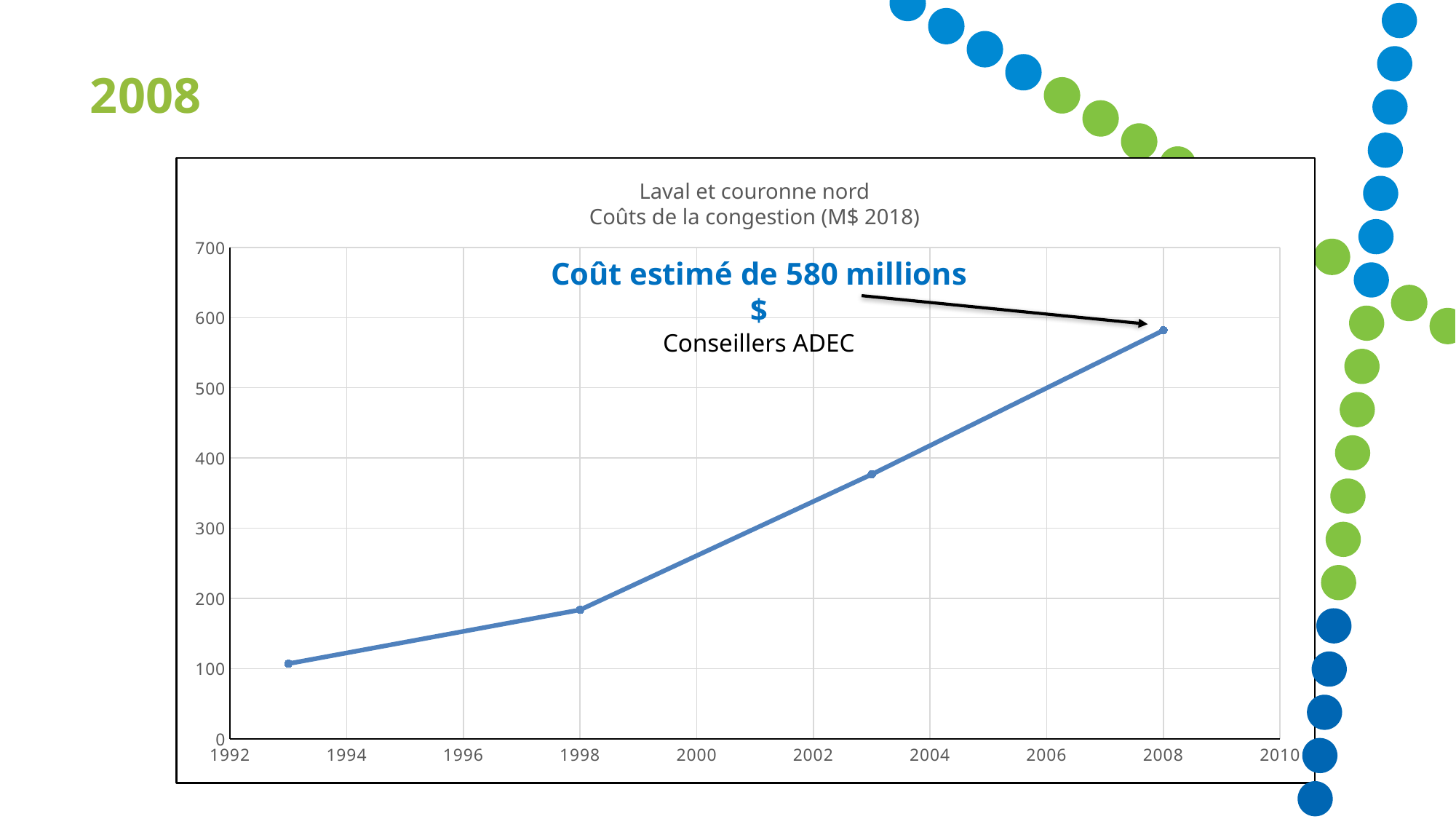
What is the title of the chart? Laval et couronne nord Coûts de la congestion (M$ 2018) Is the value for 1998 greater or less than 200? less What kind of chart is shown on the slide? line chart According to the annotation on the chart, what is the estimated cost for 2008? 580 millions $ Which year has the lowest congestion cost? 1993 Which year has the highest congestion cost? 2008 How many data points are plotted on the line? 4 Do the congestion costs rise or fall from 1993 to 2008? rise Which is larger, the value for 2003 or the value for 1998? 2003 Is the value for 2008 greater or less than 500? greater Is the value for 1993 greater or less than 200? less